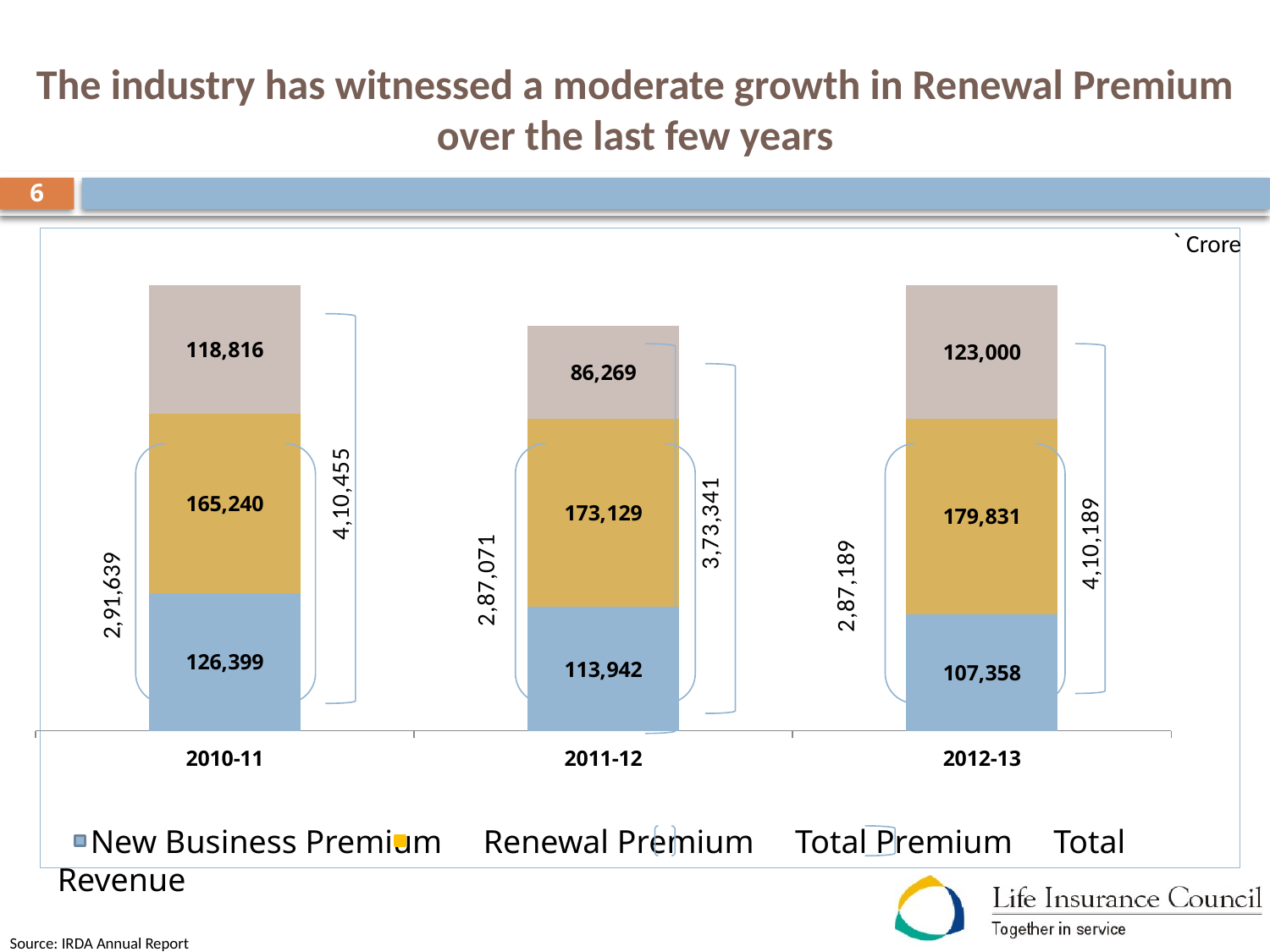
How many years are shown on the x axis? 3 What is the Total Premium figure shown by the bracket for 2010-11? 2,91,639 What is the Renewal Premium value for 2011-12? 173,129 Does Renewal Premium rise or fall from 2010-11 to 2012-13? rise Which year had the larger New Business Premium, 2010-11 or 2011-12? 2010-11 By how much did Renewal Premium in 2012-13 exceed Renewal Premium in 2010-11? 14,591 What is the New Business Premium value for 2010-11? 126,399 How many entries does the legend list? 4 What is the Renewal Premium value for 2012-13? 179,831 What is the Total Revenue figure shown by the bracket for 2011-12? 3,73,341 Which year has the highest Renewal Premium? 2012-13 Which year has the lowest New Business Premium? 2012-13